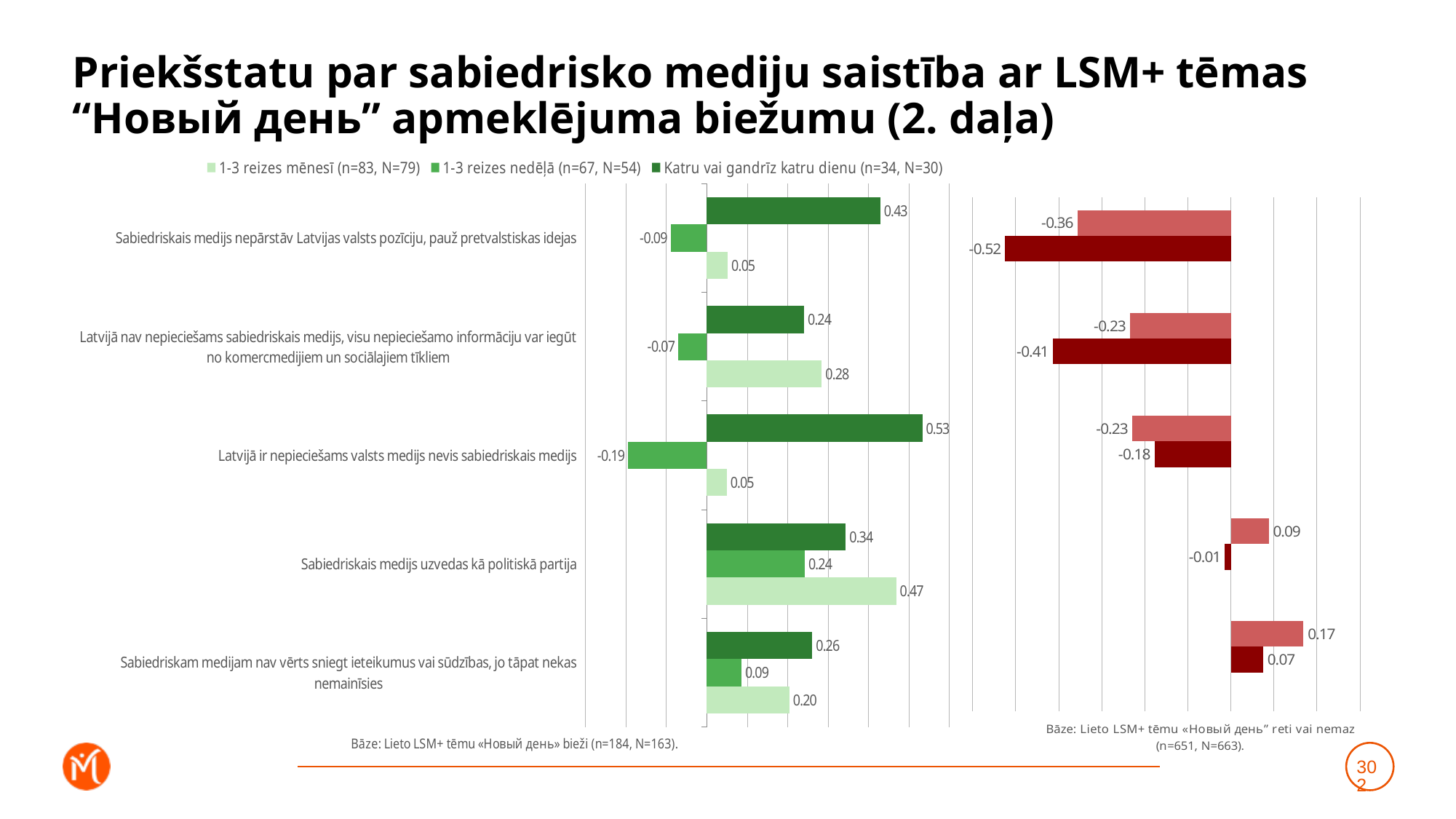
In the right (red) chart, what is the value of the lighter red bar for the statement "Sabiedriskam medijam nav vērts sniegt ieteikumus vai sūdzības, jo tāpat nekas nemainīsies"? 0.17 In the left (green) chart, what is the value for "1-3 reizes nedēļā" for the statement "Sabiedriskais medijs nepārstāv Latvijas valsts pozīciju, pauž pretvalstiskas idejas"? -0.09 In the left (green) chart, which statement has the lowest value for "1-3 reizes nedēļā"? Latvijā ir nepieciešams valsts medijs nevis sabiedriskais medijs What type of chart is the left (green) chart? Bar chart In the right (red) chart, what is the value of the dark red bar for the statement "Sabiedriskais medijs nepārstāv Latvijas valsts pozīciju, pauž pretvalstiskas idejas"? -0.52 In the left (green) chart, which statement has the highest value for "Katru vai gandrīz katru dienu"? Latvijā ir nepieciešams valsts medijs nevis sabiedriskais medijs In the left (green) chart, for "Sabiedriskais medijs uzvedas kā politiskā partija", which is larger: the "1-3 reizes mēnesī" value or the "Katru vai gandrīz katru dienu" value? 1-3 reizes mēnesī In the left (green) chart, what is the value for "Katru vai gandrīz katru dienu" for the statement "Latvijā ir nepieciešams valsts medijs nevis sabiedriskais medijs"? 0.53 In the left (green) chart, what is the value for "1-3 reizes mēnesī" for the statement "Sabiedriskais medijs uzvedas kā politiskā partija"? 0.47 In the left (green) chart, what is the difference between the "Katru vai gandrīz katru dienu" value (0.43) and the "1-3 reizes mēnesī" value (0.05) for "Sabiedriskais medijs nepārstāv Latvijas valsts pozīciju, pauž pretvalstiskas idejas"? 0.38 How many series does the legend at the top of the slide list? 3 How many statements (categories) are shown in the left (green) chart? 5